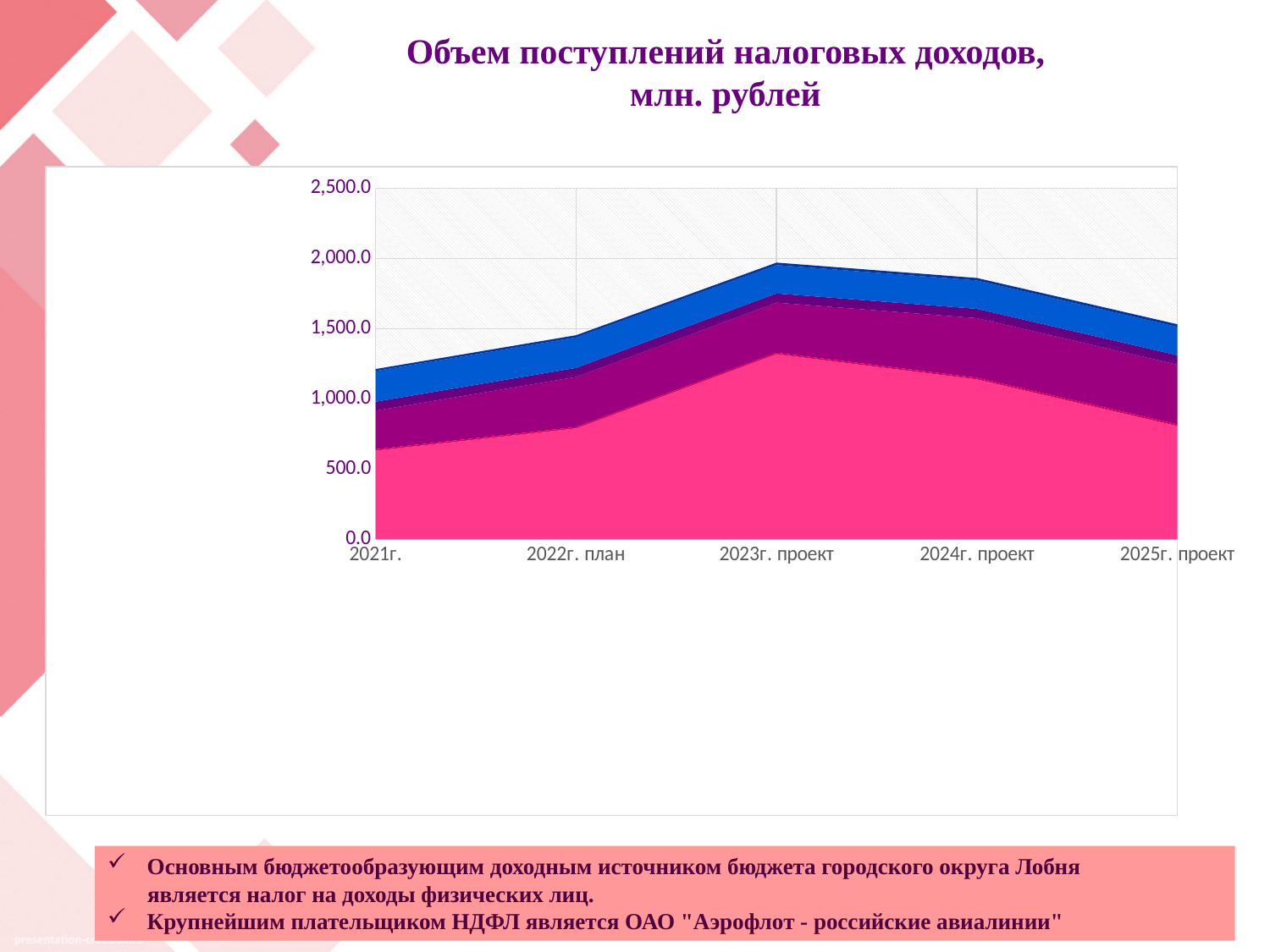
Which category has the lowest total value? 2021г. How does the total value change from 2021г. to 2023г. проект? It rises How many categories are shown along the x axis? 5 Which category has the highest total value? 2023г. проект Is the total value for 2021г. greater or less than 1,000.0? greater Is the total value for 2024г. проект greater or less than 2,000.0? less Is the total value for 2025г. проект greater or less than 1,000.0? greater What is the title of the chart? Объем поступлений налоговых доходов, млн. рублей What kind of chart is shown on the slide? Stacked area chart Is the total value for 2023г. проект larger or smaller than the total for 2025г. проект? larger